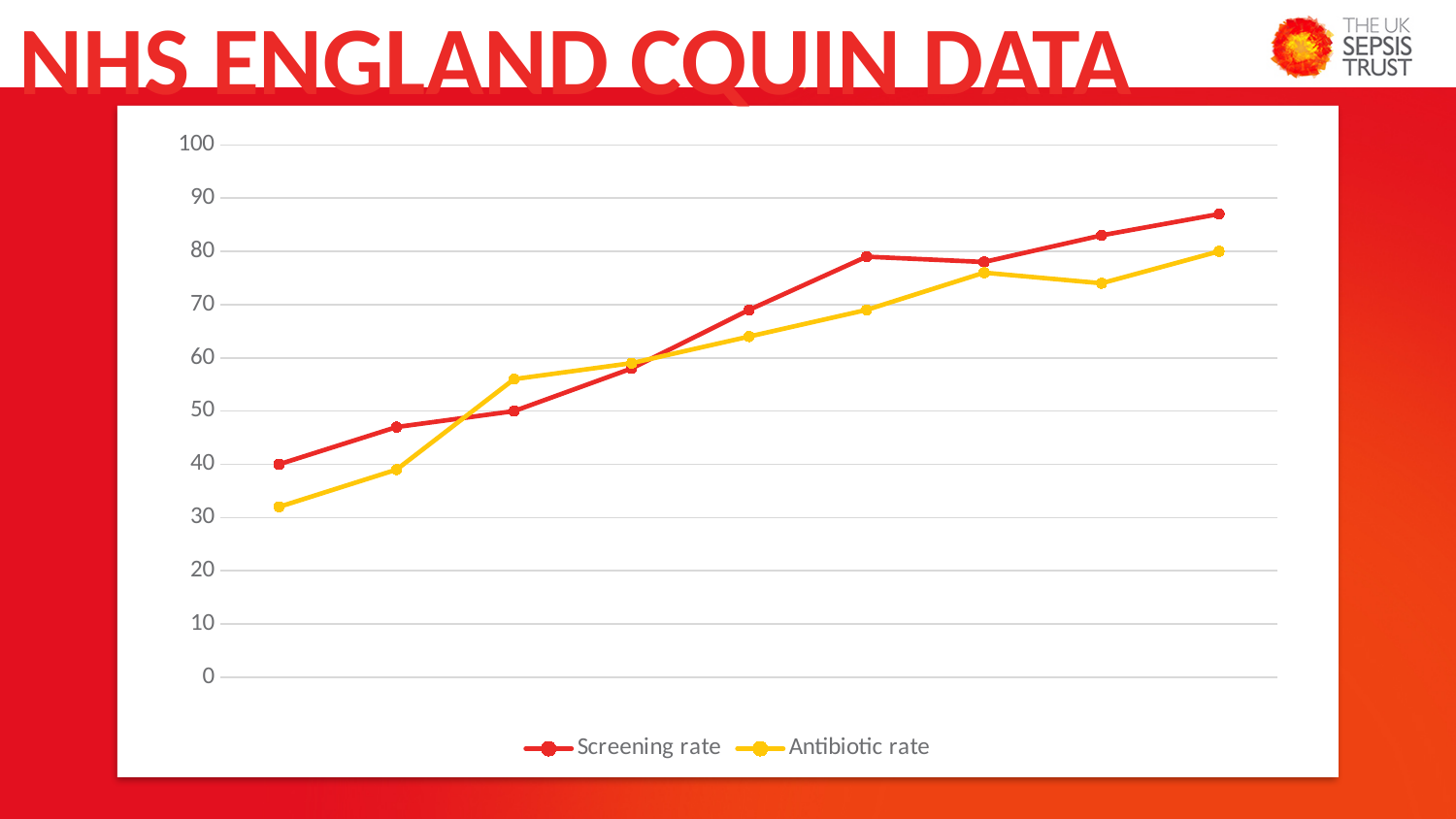
Which colour is used for the Antibiotic rate line? yellow Do the Antibiotic rate values generally rise or fall from left to right? rise What kind of chart is shown on the slide? line chart How many series does the legend list? 2 Do the Screening rate values generally rise or fall from left to right? rise What are the two series named in the legend? Screening rate and Antibiotic rate Is the last Antibiotic rate value greater or less than 90? less How many data points does the Screening rate line have? 9 At the first data point, which series has the higher value, Screening rate or Antibiotic rate? Screening rate At the last data point, which series has the higher value, Screening rate or Antibiotic rate? Screening rate Is the first Antibiotic rate value greater or less than 40? less Is the last Screening rate value greater or less than 80? greater